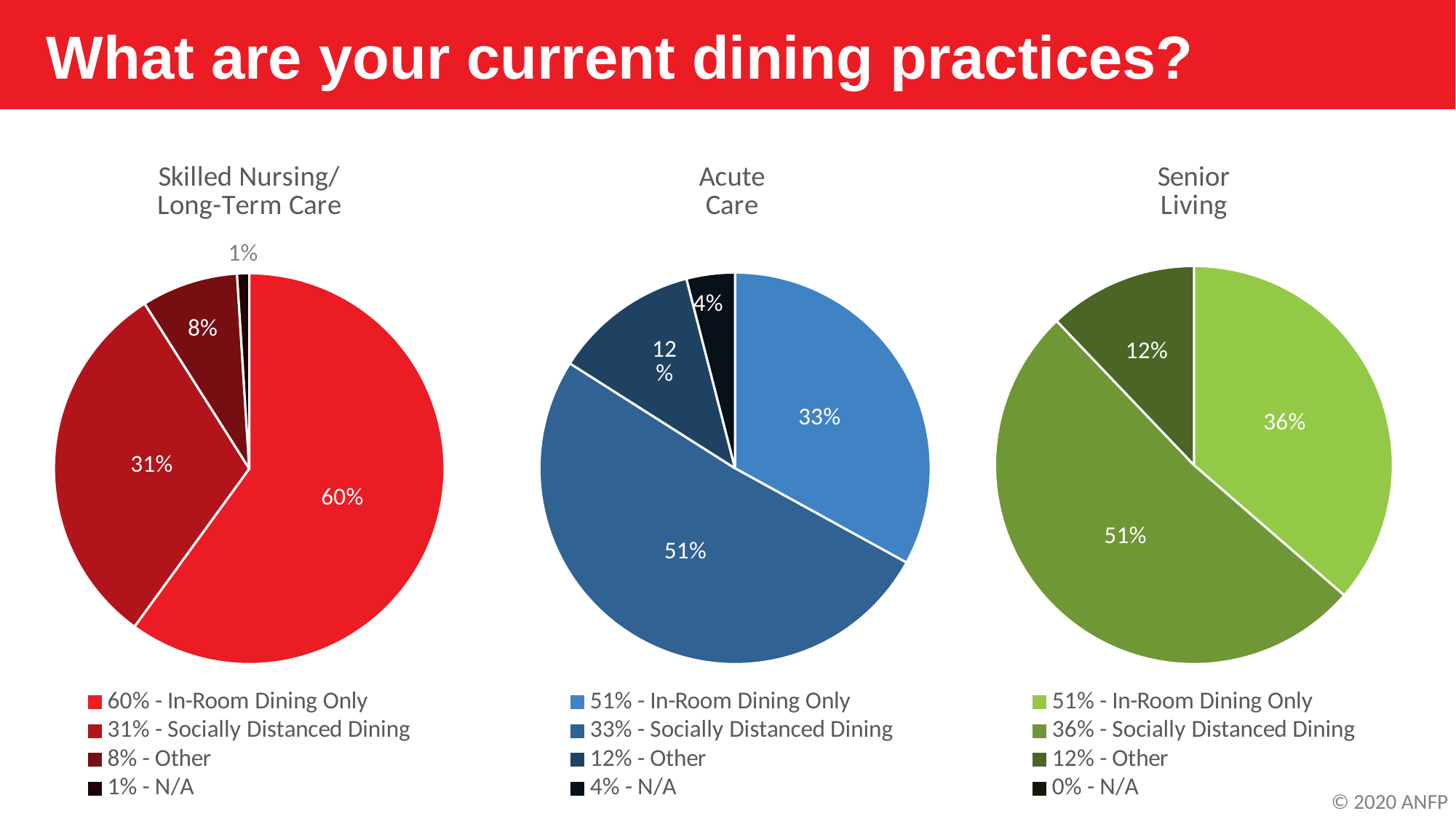
In the Senior Living pie chart, what share is N/A? 0% In the Skilled Nursing/Long-Term Care pie chart, what share is Other? 8% In the Skilled Nursing/Long-Term Care pie chart, what share is In-Room Dining Only? 60% In the Skilled Nursing/Long-Term Care pie chart, what share is Socially Distanced Dining? 31% What is the largest percentage shown in the Acute Care pie chart? 51% In the Senior Living pie chart, what share is Other? 12% In the Skilled Nursing/Long-Term Care pie chart, what is the difference between the In-Room Dining Only share and the Socially Distanced Dining share? 29% What type of chart is used for Acute Care? Pie chart How many categories does the legend of the Senior Living pie chart list? 4 In the Acute Care pie chart, what share is N/A? 4% In the Skilled Nursing/Long-Term Care pie chart, which category has the smallest share? N/A In the Skilled Nursing/Long-Term Care pie chart, which category has the largest share? In-Room Dining Only